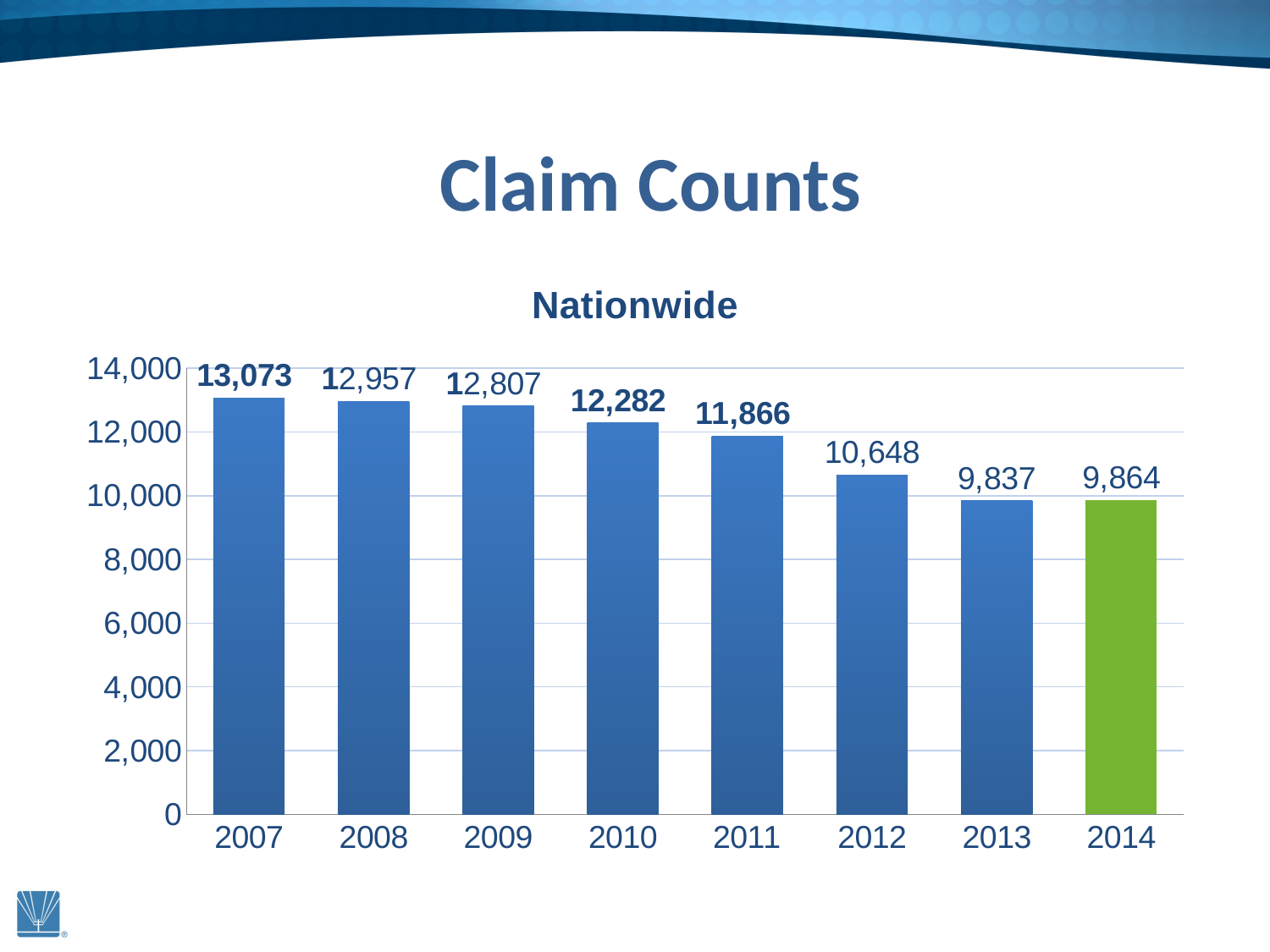
Which year has a larger claim count, 2009 or 2011? 2009 What is the claim count for 2012? 10,648 Which year has the lowest claim count? 2013 What is the claim count for 2014? 9,864 How many years are shown on the chart? 8 Do the claim counts generally rise or fall from 2007 to 2013? fall What is the claim count for 2010? 12,282 What kind of chart is shown on the slide? bar chart Which year has the highest claim count? 2007 Is the claim count for 2013 greater or less than 10,000? less What is the difference between the claim counts for 2007 and 2014? 3,209 What is the difference between the claim counts for 2011 and 2012? 1,218